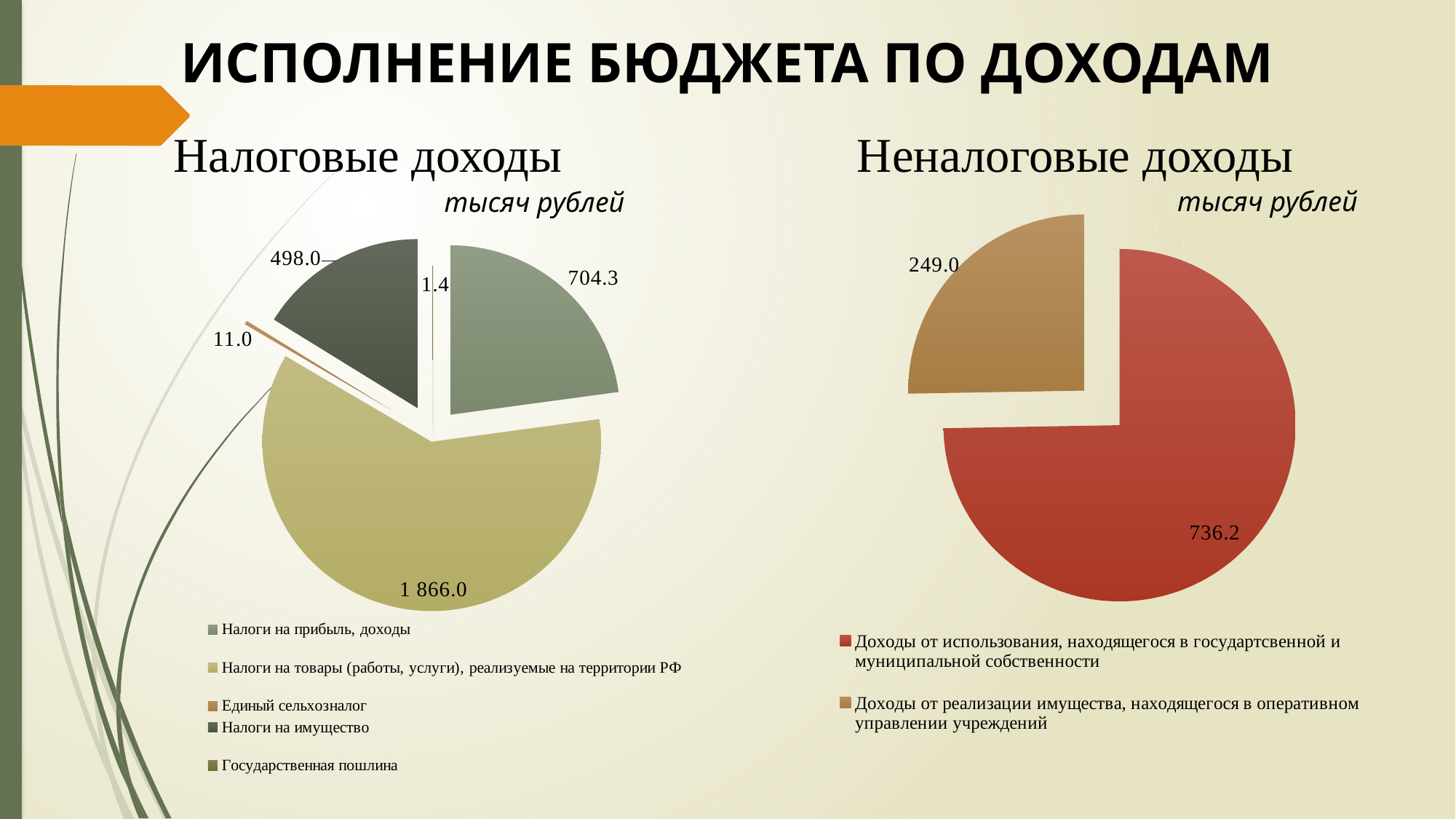
In the "Неналоговые доходы" chart, what is the value for "Доходы от реализации имущества, находящегося в оперативном управлении учреждений"? 249.0 In the "Налоговые доходы" chart, what is the value for "Государственная пошлина"? 1.4 In the "Налоговые доходы" chart, what is the value for "Налоги на товары (работы, услуги), реализуемые на территории РФ"? 1 866.0 In the "Налоговые доходы" chart, which category has the largest value? Налоги на товары (работы, услуги), реализуемые на территории РФ In the "Неналоговые доходы" chart, which is larger: "Доходы от использования, находящегося в государтсвенной и муниципальной собственности" or "Доходы от реализации имущества, находящегося в оперативном управлении учреждений"? Доходы от использования, находящегося в государтсвенной и муниципальной собственности In the "Налоговые доходы" chart, what is the difference between "Налоги на прибыль, доходы" and "Налоги на имущество"? 206.3 How many slices does the "Налоговые доходы" pie chart have? 5 In the "Налоговые доходы" chart, which category has the smallest value? Государственная пошлина In the "Налоговые доходы" chart, what is the value for "Налоги на имущество"? 498.0 In the "Неналоговые доходы" chart, what is the difference between the two slices? 487.2 What unit is stated for the values in both charts? тысяч рублей What kind of chart is used for "Налоговые доходы"? Pie chart